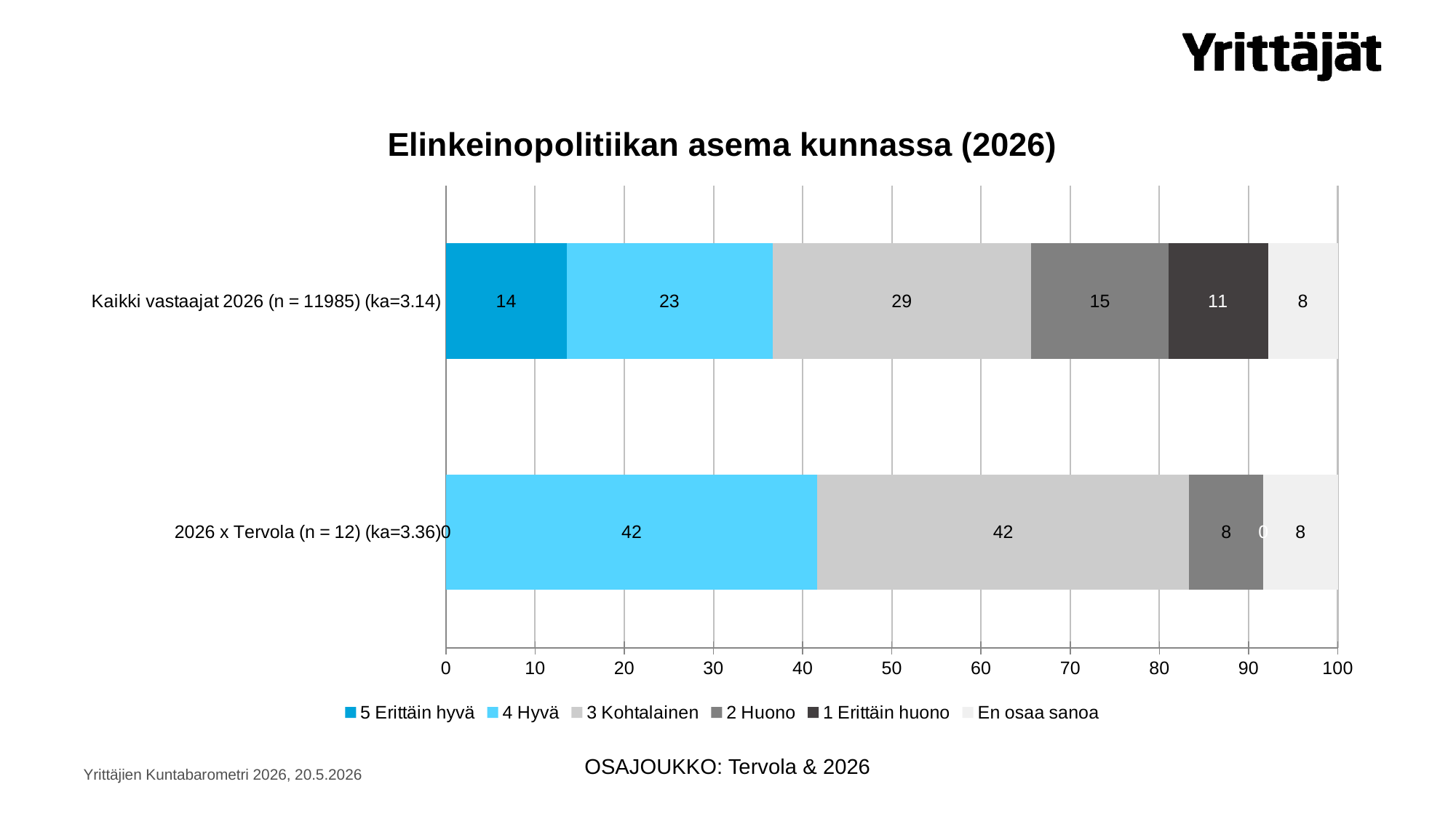
What is the value for "3 Kohtalainen" in the "2026 x Tervola (n = 12) (ka=3.36)" bar? 42 Which series has the largest value in the "Kaikki vastaajat 2026 (n = 11985) (ka=3.14)" bar? 3 Kohtalainen What is the total of the stacked bar for "2026 x Tervola (n = 12) (ka=3.36)"? 100 What is the difference between the "2 Huono" values for "Kaikki vastaajat 2026" and "2026 x Tervola"? 7 Which bar has the larger value for "4 Hyvä": "Kaikki vastaajat 2026" or "2026 x Tervola"? 2026 x Tervola What is the value for "1 Erittäin huono" in the "Kaikki vastaajat 2026 (n = 11985) (ka=3.14)" bar? 11 What is the title of the chart? Elinkeinopolitiikan asema kunnassa (2026) What is the value for "4 Hyvä" in the "Kaikki vastaajat 2026 (n = 11985) (ka=3.14)" bar? 23 What kind of chart is shown on the slide? Stacked bar chart How many series does the legend list? 6 How many bars (categories) are shown in the chart? 2 What is the value for "5 Erittäin hyvä" in the "2026 x Tervola (n = 12) (ka=3.36)" bar? 0